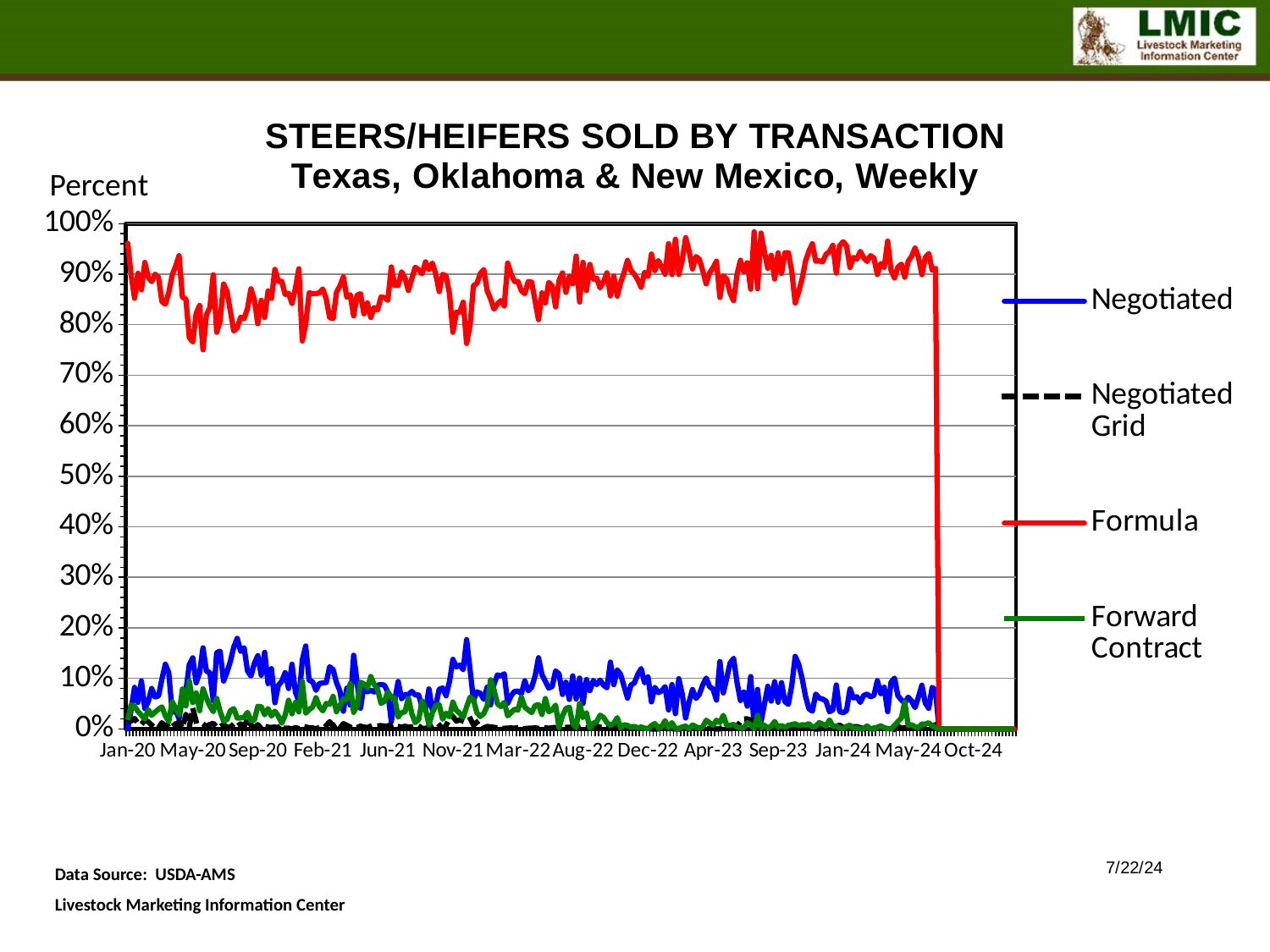
Which is larger in Sep-23, the value for Formula or the value for Negotiated? Formula Is the value for Formula in Jan-24 greater or less than 70%? greater How many series does the legend list? 4 Which series has the highest values throughout the chart? Formula What colour is the line for Forward Contract? green Is the value for Negotiated in Jan-20 greater or less than 20%? less Which series has the lowest values throughout the chart? Negotiated Grid What is the title of the chart? STEERS/HEIFERS SOLD BY TRANSACTION Texas, Oklahoma & New Mexico, Weekly What kind of chart is shown on the slide? line chart Is the value for Forward Contract in Jan-24 greater or less than 10%? less